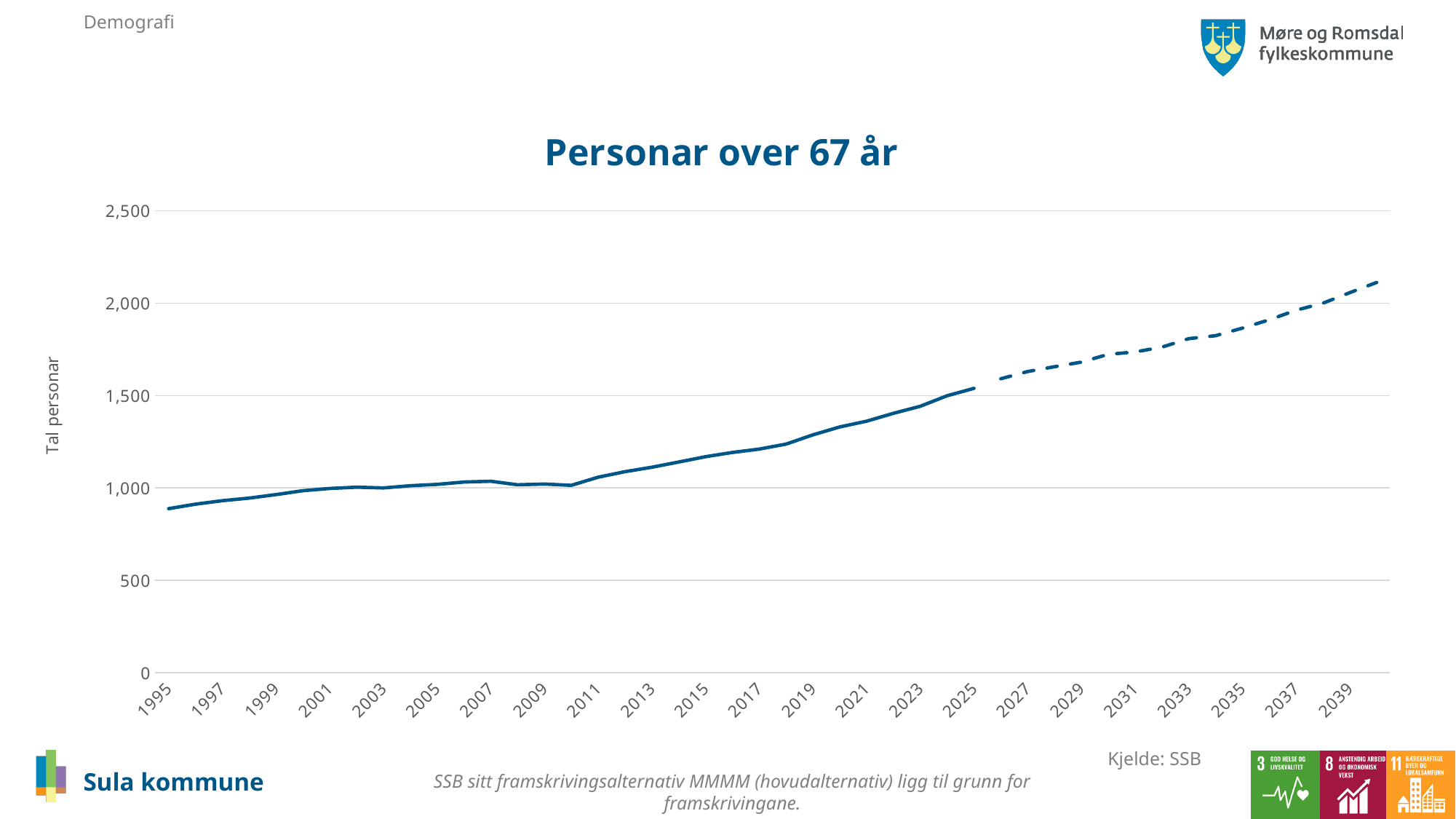
Is the value for 1995 greater or less than 1,000? less How many year labels are shown on the horizontal axis? 23 What is the label on the vertical axis of the chart? Tal personar Is the value for 2023 larger or smaller than the value for 2003? larger What is the title of the chart? Personar over 67 år Do the values in the chart generally rise or fall from 1995 to 2040? rise What kind of chart is shown on the slide? line chart Is the value for 2025 greater or less than 1,500? greater Is the value at the end of the dashed line (around 2040) greater or less than 2,000? greater Which year has the lowest value in the chart? 1995